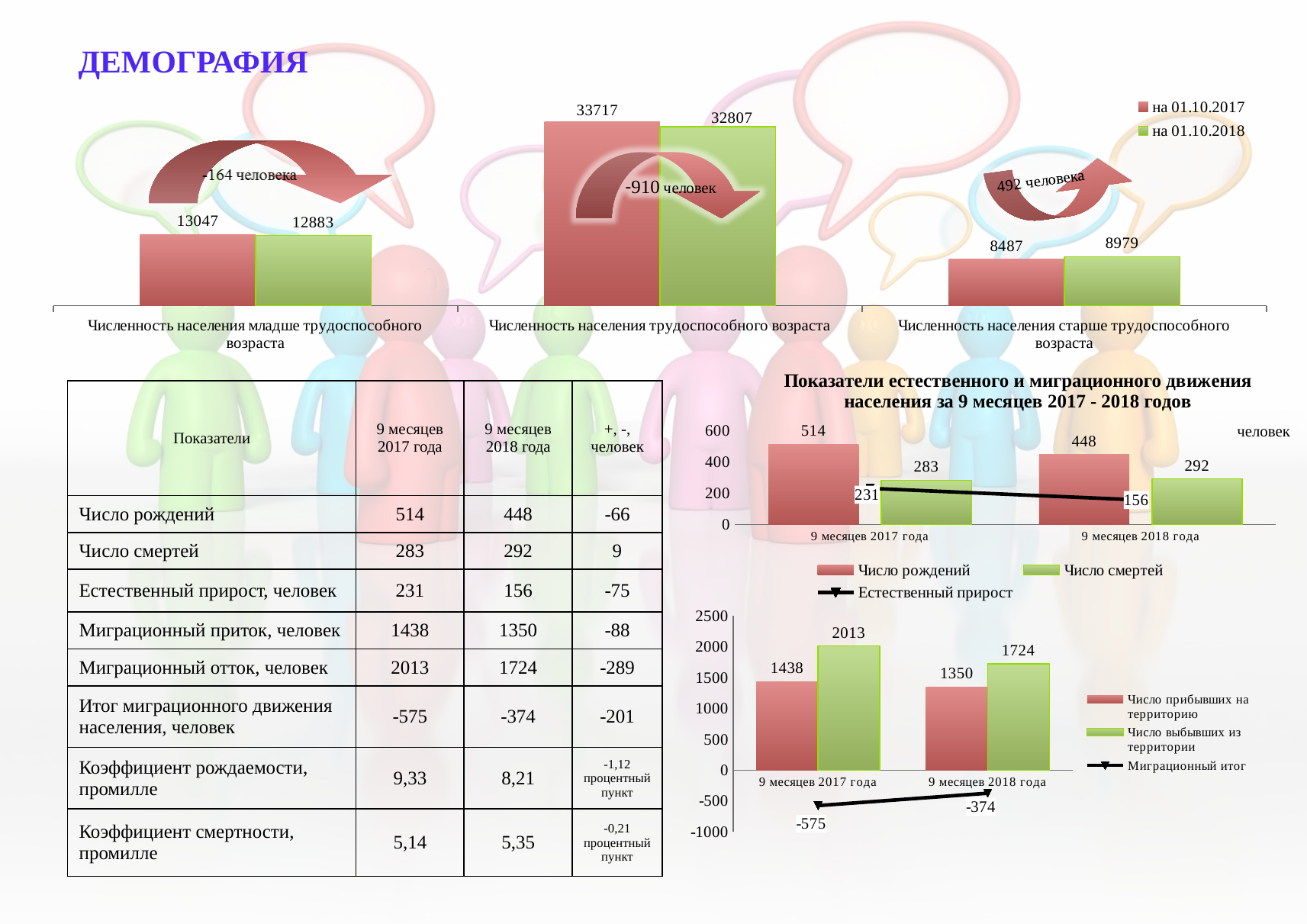
In the top population chart, what is the value for 'Численность населения трудоспособного возраста' on 01.10.2017? 33717 In the top population chart, how many series does the legend list? 2 In the top population chart, which category has the highest values? Численность населения трудоспособного возраста In the chart 'Показатели естественного и миграционного движения населения за 9 месяцев 2017 - 2018 годов', what is the value of 'Число рождений' for 9 месяцев 2018 года? 448 What type of chart is the bottom-right migration chart? bar chart with a line In the chart 'Показатели естественного и миграционного движения населения за 9 месяцев 2017 - 2018 годов', what is the value of 'Естественный прирост' for 9 месяцев 2017 года? 231 In the top population chart, what is the value for 'Численность населения старше трудоспособного возраста' on 01.10.2018? 8979 In the chart 'Показатели естественного и миграционного движения населения за 9 месяцев 2017 - 2018 годов', does 'Число рождений' rise or fall from 2017 to 2018? fall In the top population chart, what is the difference between the 01.10.2017 and 01.10.2018 values for 'Численность населения младше трудоспособного возраста'? 164 In the chart 'Показатели естественного и миграционного движения населения за 9 месяцев 2017 - 2018 годов', which is larger: 'Число смертей' for 2017 or for 2018? 2018 In the bottom-right migration chart, what is the value of 'Число выбывших из территории' for 9 месяцев 2017 года? 2013 In the bottom-right migration chart, what is the difference between 'Число выбывших из территории' and 'Число прибывших на территорию' for 9 месяцев 2018 года? 374